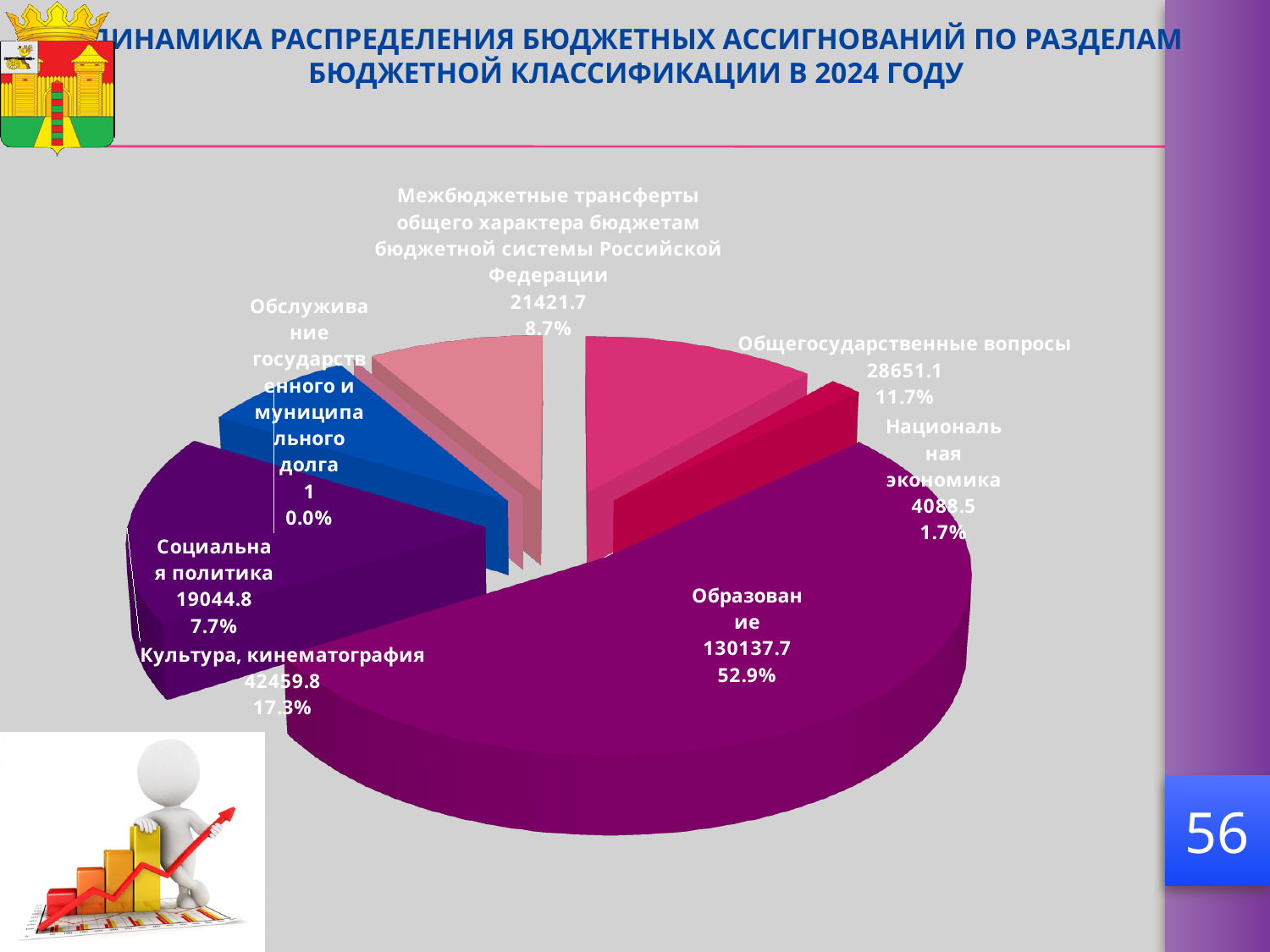
How many categories (slices) does the pie chart show? 7 Which category has the largest share of the pie? Образование What percentage is shown for Социальная политика? 7.7% What percentage is shown for Общегосударственные вопросы? 11.7% What share of the pie does Образование represent? 52.9% What is the difference between the values for Общегосударственные вопросы and Социальная политика? 9606.3 Which is larger: Социальная политика or Межбюджетные трансферты общего характера бюджетам бюджетной системы Российской Федерации? Межбюджетные трансферты общего характера бюджетам бюджетной системы Российской Федерации What kind of chart is shown on the slide? Pie chart What is the value shown for Образование? 130137.7 What is the value shown for Национальная экономика? 4088.5 What is the value shown for Культура, кинематография? 42459.8 Which category has the smallest share of the pie? Обслуживание государственного и муниципального долга